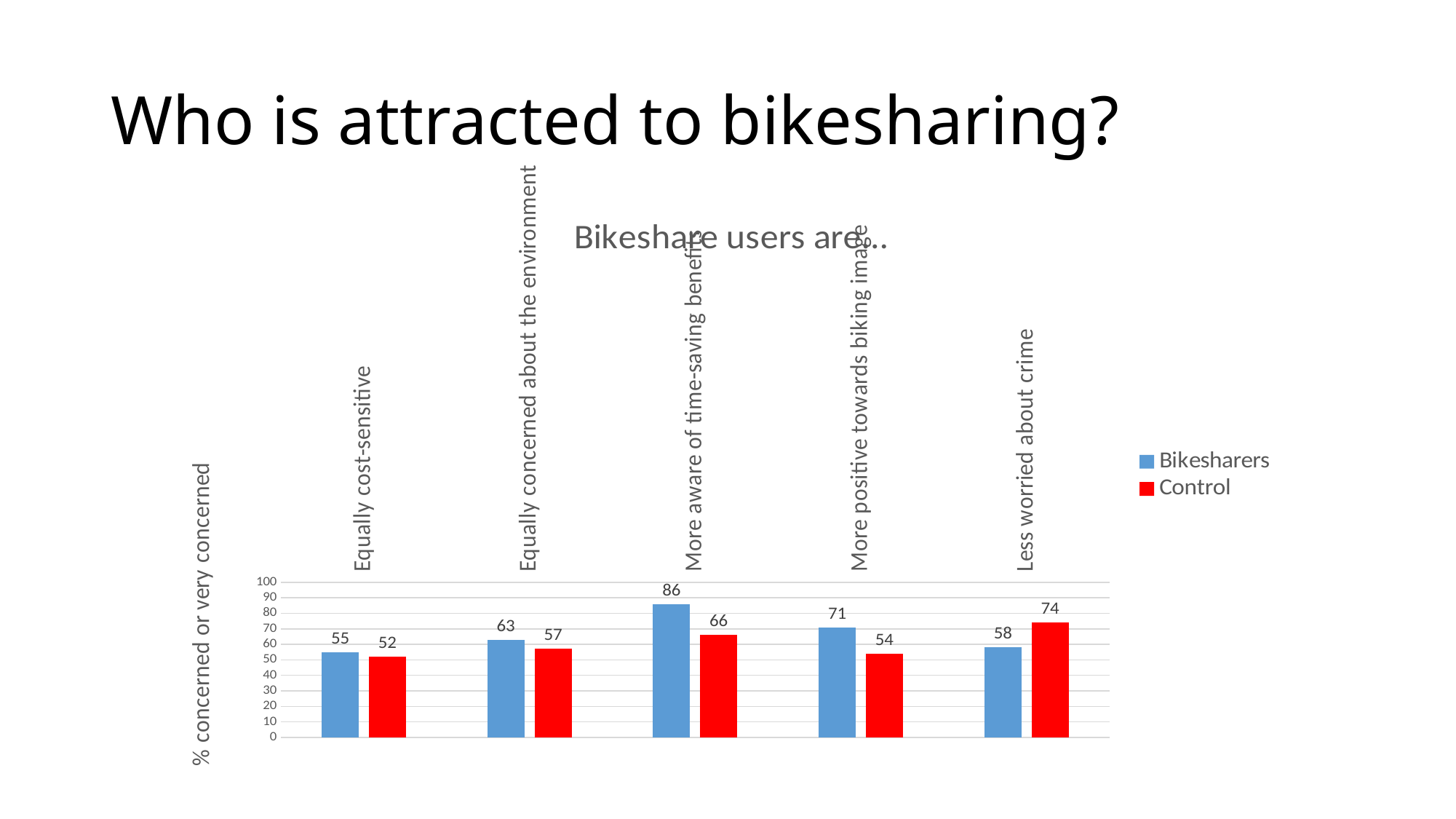
What is the value for Bikesharers in the 'More aware of time-saving benefits' category? 86 What is the value for Control in the 'Equally cost-sensitive' category? 52 Is the Bikesharers value for 'Equally concerned about the environment' greater or less than 50? greater How many categories are shown on the x axis? 5 What is the value for Control in the 'Less worried about crime' category? 74 What is the title of the chart? Bikeshare users are... What kind of chart is shown on the slide? Bar chart What is the difference between Bikesharers and Control in the 'More positive towards biking image' category? 17 Which category has the highest Bikesharers value? More aware of time-saving benefits Which category has the lowest Control value? Equally cost-sensitive In the 'Less worried about crime' category, which series has the larger value, Bikesharers or Control? Control How many series does the legend list? 2